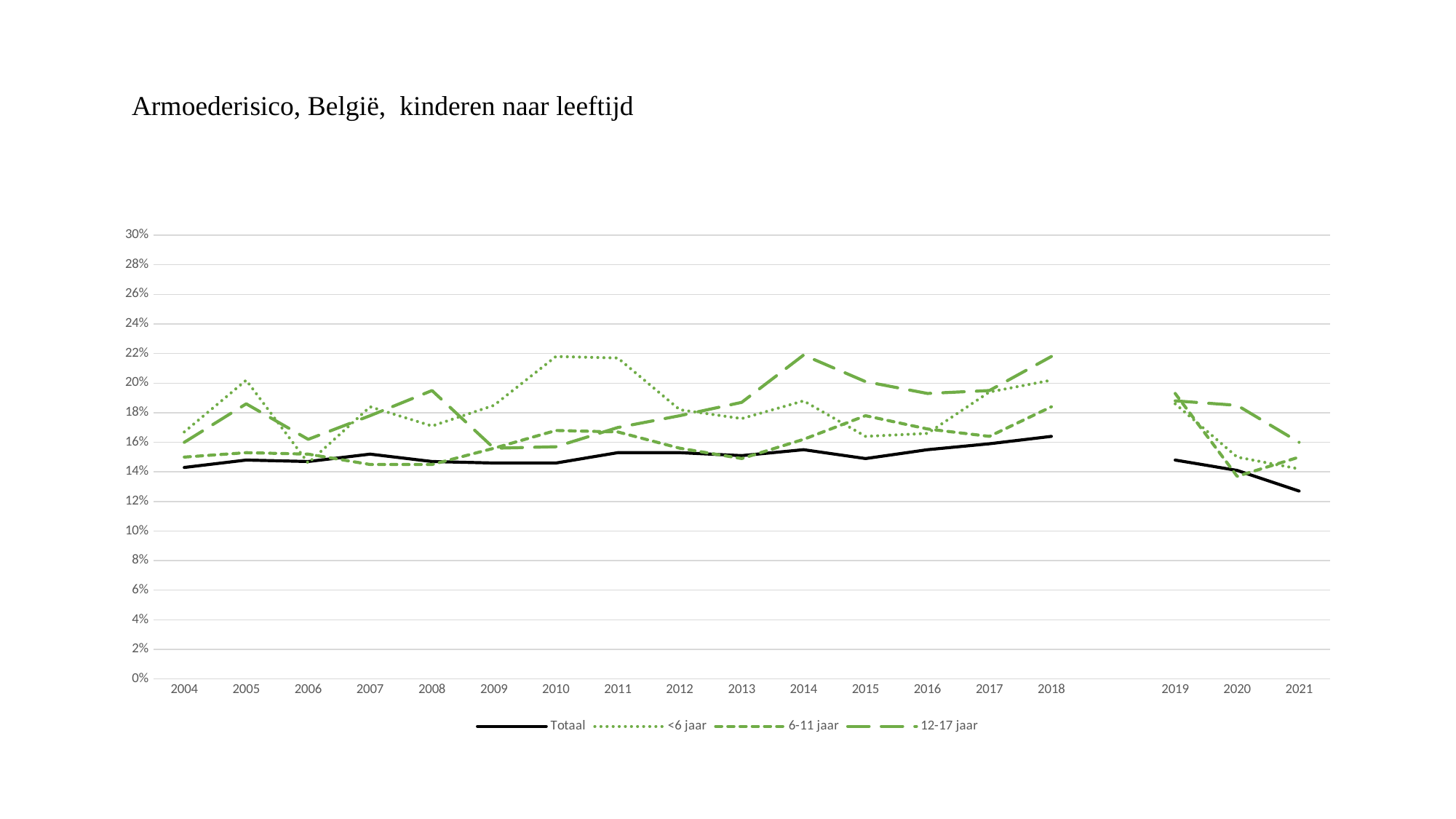
Is the value for 6-11 jaar in 2018 greater or less than 16%? greater Which series has the lowest value in 2021? Totaal Which series has the highest value in 2010? <6 jaar Does the Totaal line rise or fall from 2019 to 2021? fall What is the title of the chart? Armoederisico, België, kinderen naar leeftijd Is the value for <6 jaar in 2010 greater or less than 20%? greater Which series is drawn as a solid black line? Totaal How many series does the legend list? 4 Is the value for 12-17 jaar in 2014 greater or less than 20%? greater What kind of chart is shown on the slide? line chart How many years are shown on the x axis? 18